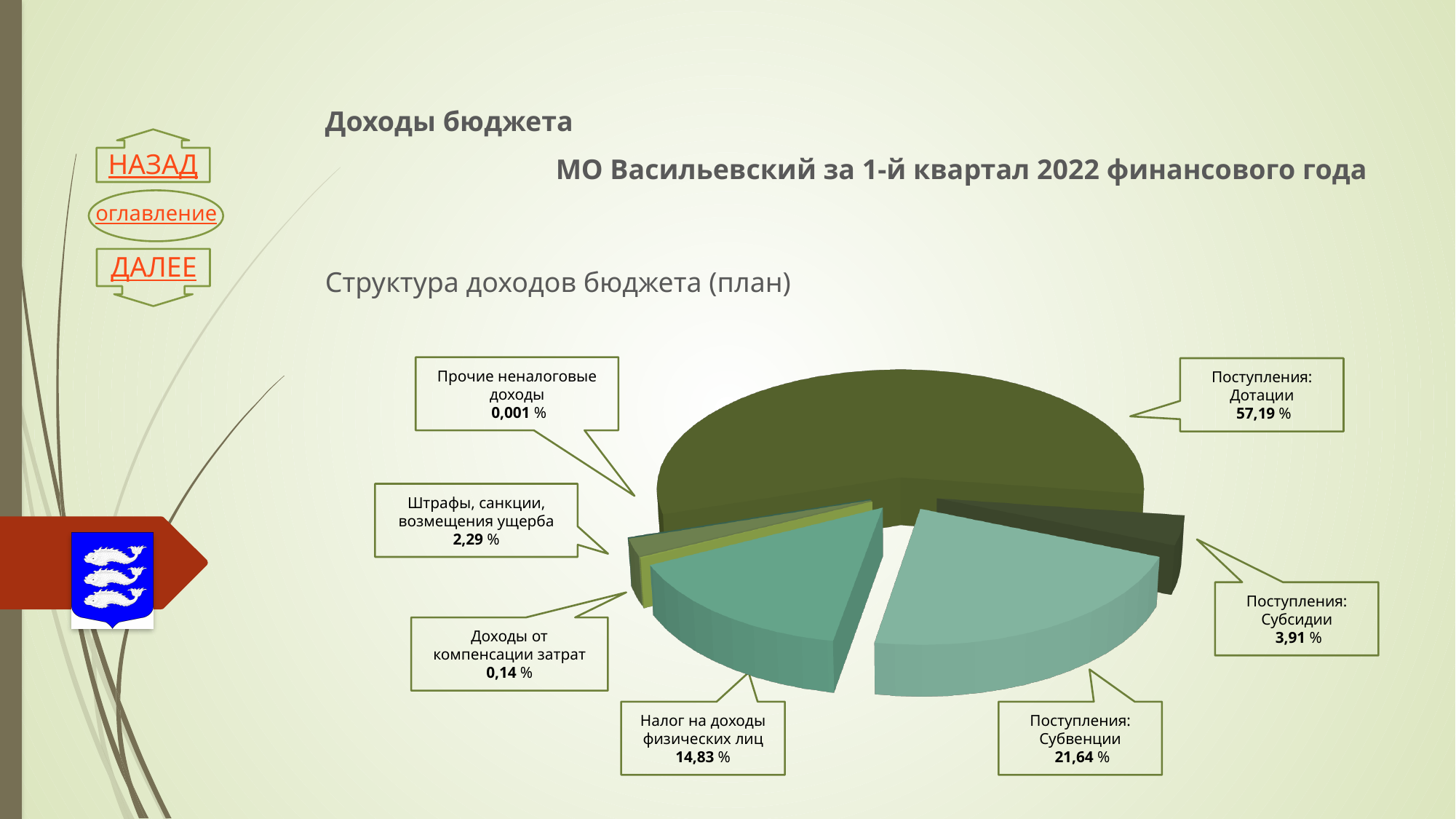
Which is larger, Поступления: Субвенции or Налог на доходы физических лиц? Поступления: Субвенции Which category has the largest share of the pie? Поступления: Дотации What is the value for Поступления: Дотации? 57,19 % What kind of chart is shown on the slide? Pie chart What is the value for Поступления: Субвенции? 21,64 % What is the value for Налог на доходы физических лиц? 14,83 % What is the difference between Поступления: Субсидии and Штрафы, санкции, возмещения ущерба? 1,62 % What is the value for Штрафы, санкции, возмещения ущерба? 2,29 % How many categories (slices) does the pie chart have? 7 What is the difference between Поступления: Дотации and Поступления: Субвенции? 35,55 % Which category has the smallest share of the pie? Прочие неналоговые доходы What is the title of the chart? Структура доходов бюджета (план)